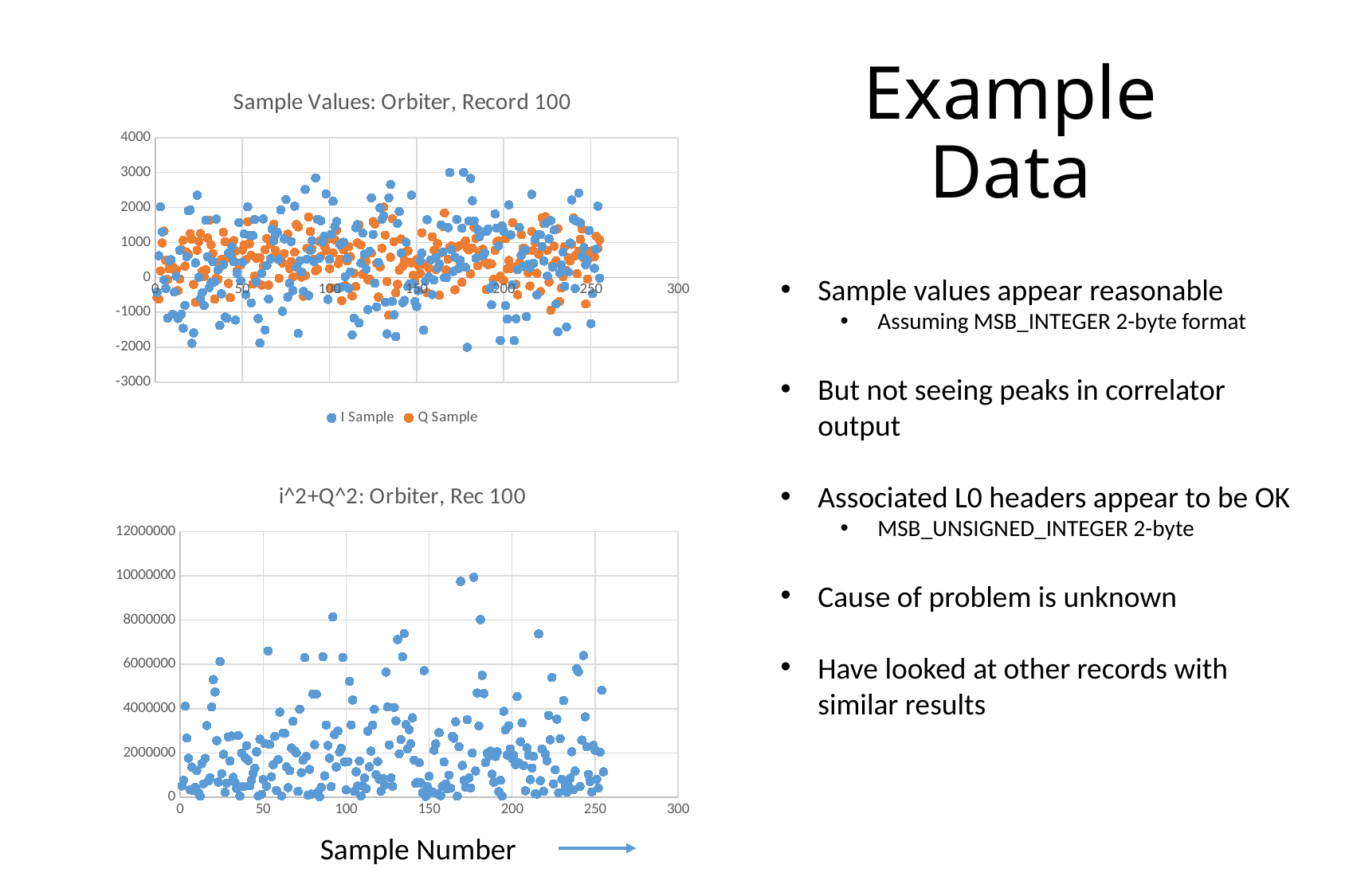
In the top chart, is the highest I Sample value greater or less than 4000? less What kind of chart is the bottom chart, 'i^2+Q^2: Orbiter, Rec 100'? scatter chart What kind of chart is the top chart, 'Sample Values: Orbiter, Record 100'? scatter chart In the top chart, which series reaches higher values, I Sample or Q Sample? I Sample In the bottom chart, is the highest plotted value greater or less than 8000000? greater What is the title of the top chart? Sample Values: Orbiter, Record 100 In the top chart, is the lowest I Sample value greater or less than -1000? less How many series does the legend of the top chart list? 2 In the top chart, which series is plotted in orange? Q Sample